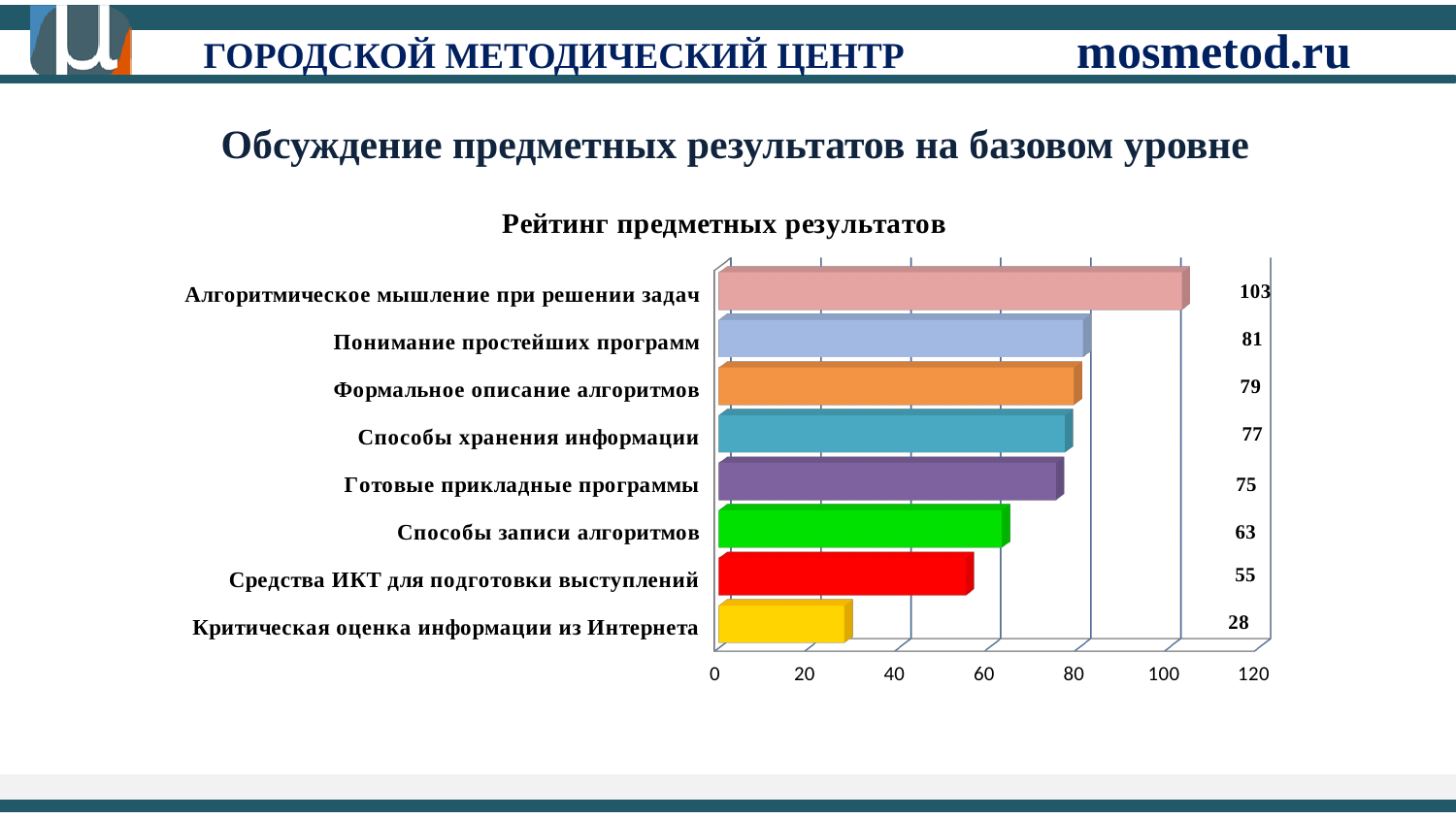
What is the difference between the values for Понимание простейших программ and Способы записи алгоритмов? 18 What is the value for Алгоритмическое мышление при решении задач? 103 How many categories are shown in the chart? 8 Which category has the highest value? Алгоритмическое мышление при решении задач Which category has the lowest value? Критическая оценка информации из Интернета Is the value for Формальное описание алгоритмов greater or less than 60? greater What is the value for Способы хранения информации? 77 What is the value for Критическая оценка информации из Интернета? 28 What kind of chart is shown on the slide? bar chart What is the maximum value shown on the horizontal axis? 120 What is the title of the chart? Рейтинг предметных результатов Which is larger: the value for Готовые прикладные программы or the value for Средства ИКТ для подготовки выступлений? Готовые прикладные программы